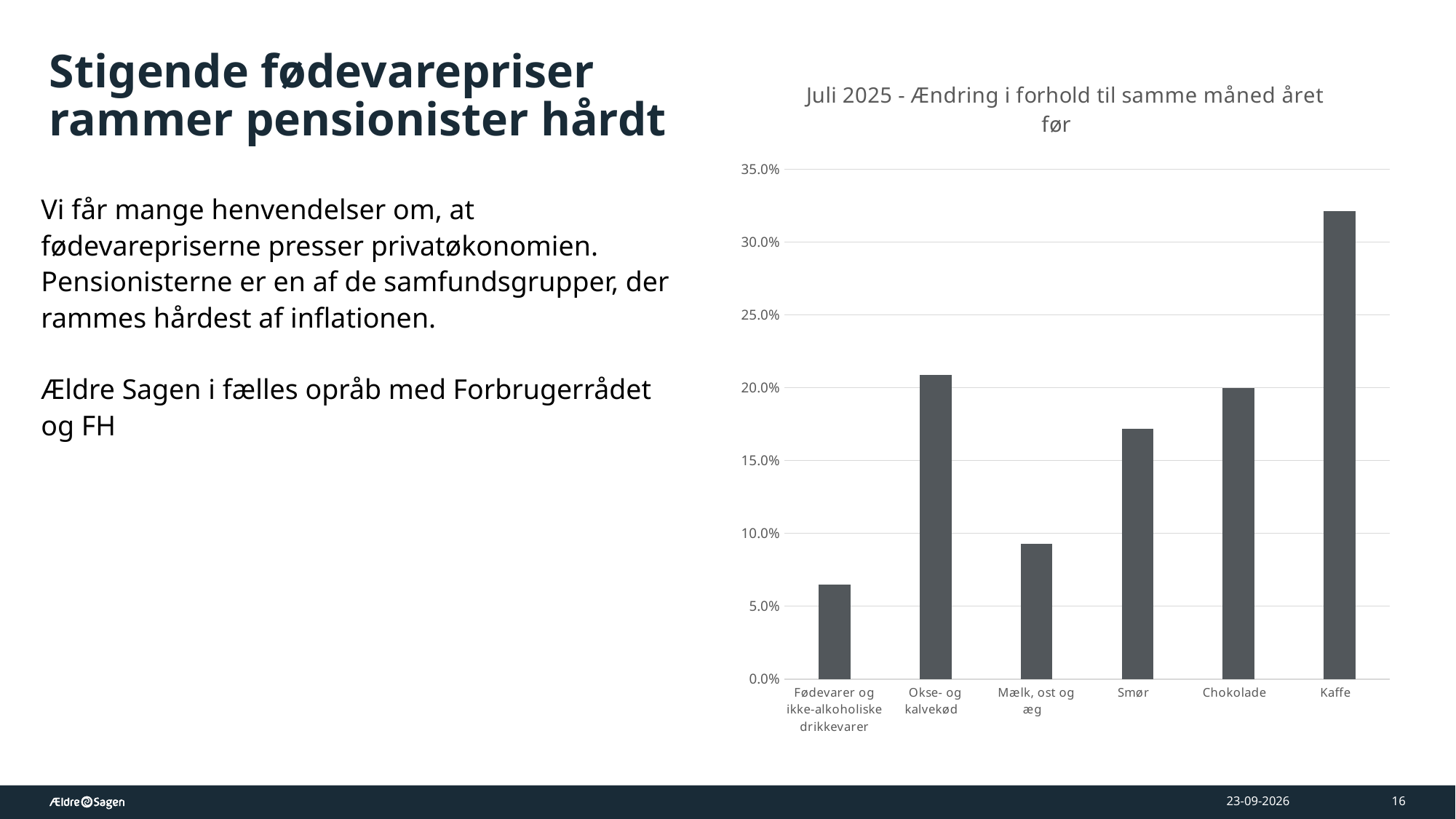
Is the value for Smør greater or less than 15.0%? greater Is the value for Mælk, ost og æg greater or less than 10.0%? less How many categories are shown in the chart? 6 Which is larger, the value for Smør or the value for Mælk, ost og æg? Smør Is the value for Fødevarer og ikke-alkoholiske drikkevarer greater or less than 5.0%? greater What is the title of the chart? Juli 2025 - Ændring i forhold til samme måned året før Which category has the highest value in the chart? Kaffe Which is larger, the value for Kaffe or the value for Chokolade? Kaffe What kind of chart is shown on the slide? Bar chart Which category has the lowest value in the chart? Fødevarer og ikke-alkoholiske drikkevarer